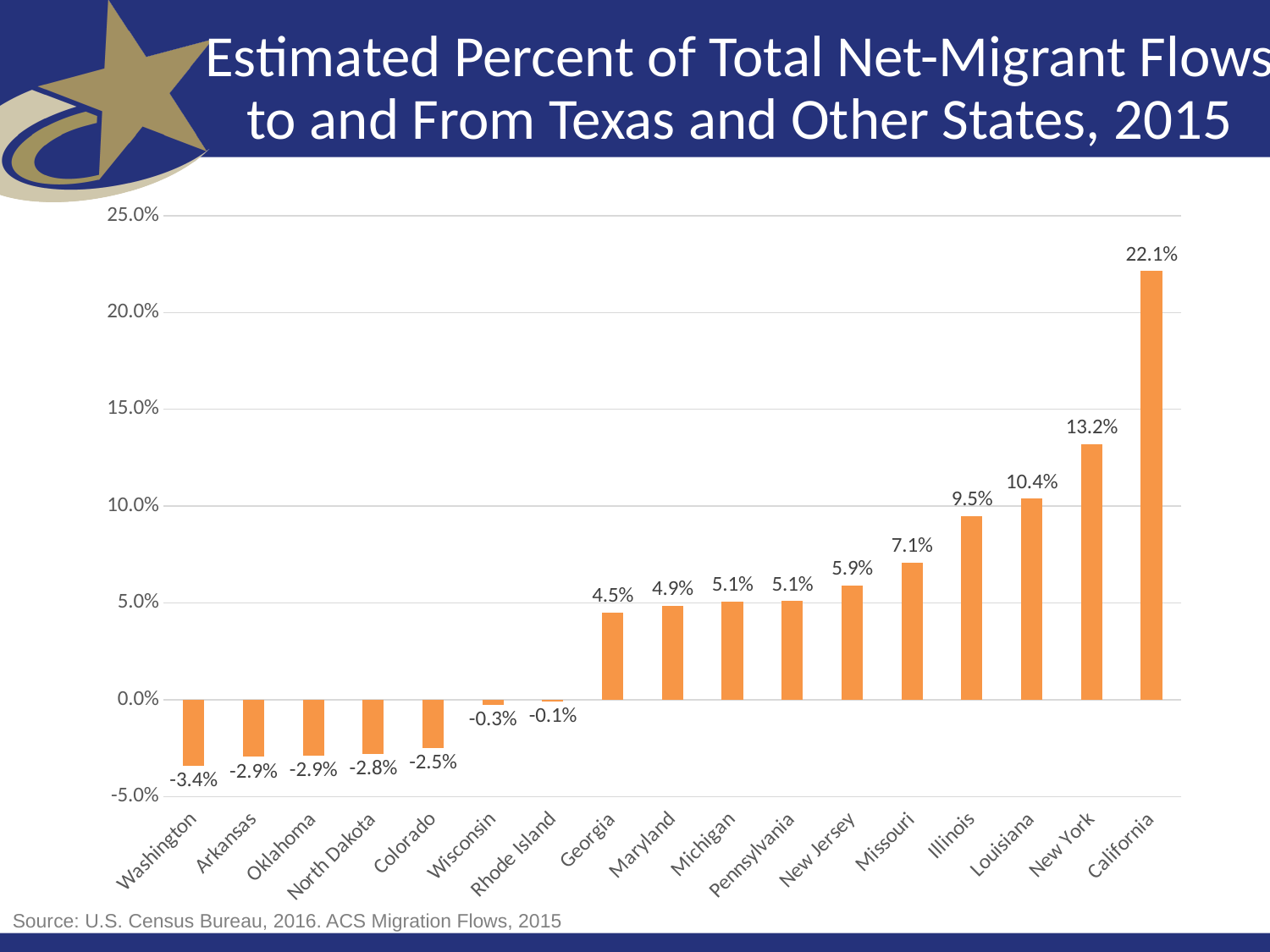
What kind of chart is shown on the slide? bar chart What is the value for Missouri? 7.1% What is the difference between the values for California and New York? 8.9% Which is larger, the value for New Jersey or the value for Georgia? New Jersey What is the value for California? 22.1% How many states are shown on the x axis? 17 What is the value for Washington? -3.4% Which state has the lowest value? Washington Do the values rise or fall moving from left to right along the x axis? rise What is the difference between the values for Louisiana and Illinois? 0.9% Which state has the highest value? California Is the value for New York greater or less than 10.0%? greater